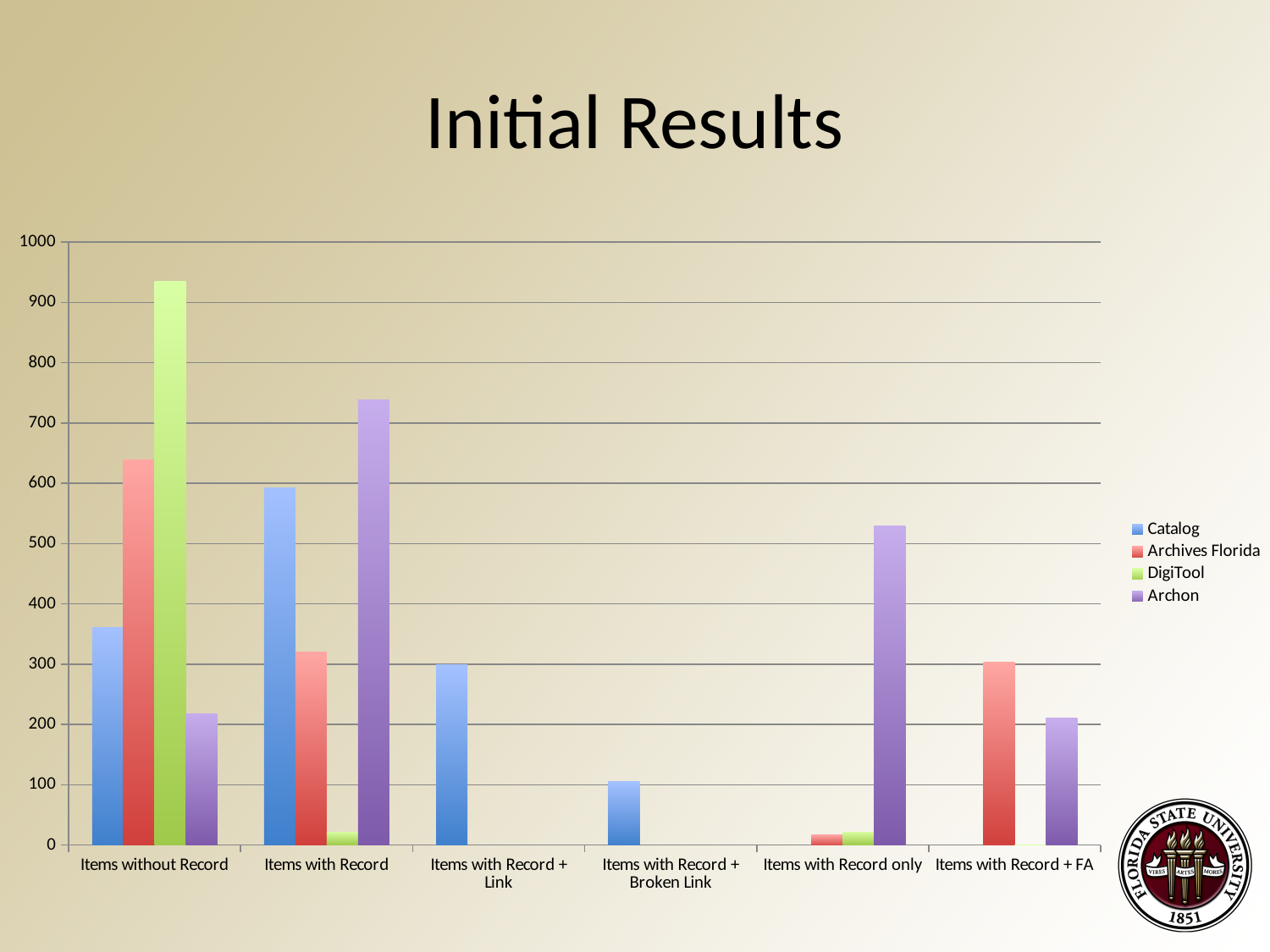
What colour represents the Archon series in the legend? purple How many categories are shown along the x axis? 6 How many series does the legend list? 4 Is the Catalog value for Items without Record greater or less than 300? greater What kind of chart is shown on the slide? bar chart For Items without Record, which series has the highest bar? DigiTool For Items with Record, which is larger: the Catalog value or the Archives Florida value? Catalog For Items with Record, which series has the highest bar? Archon Is the Archives Florida value for Items without Record greater or less than 600? greater Is the Catalog value for Items with Record + Broken Link greater or less than 200? less